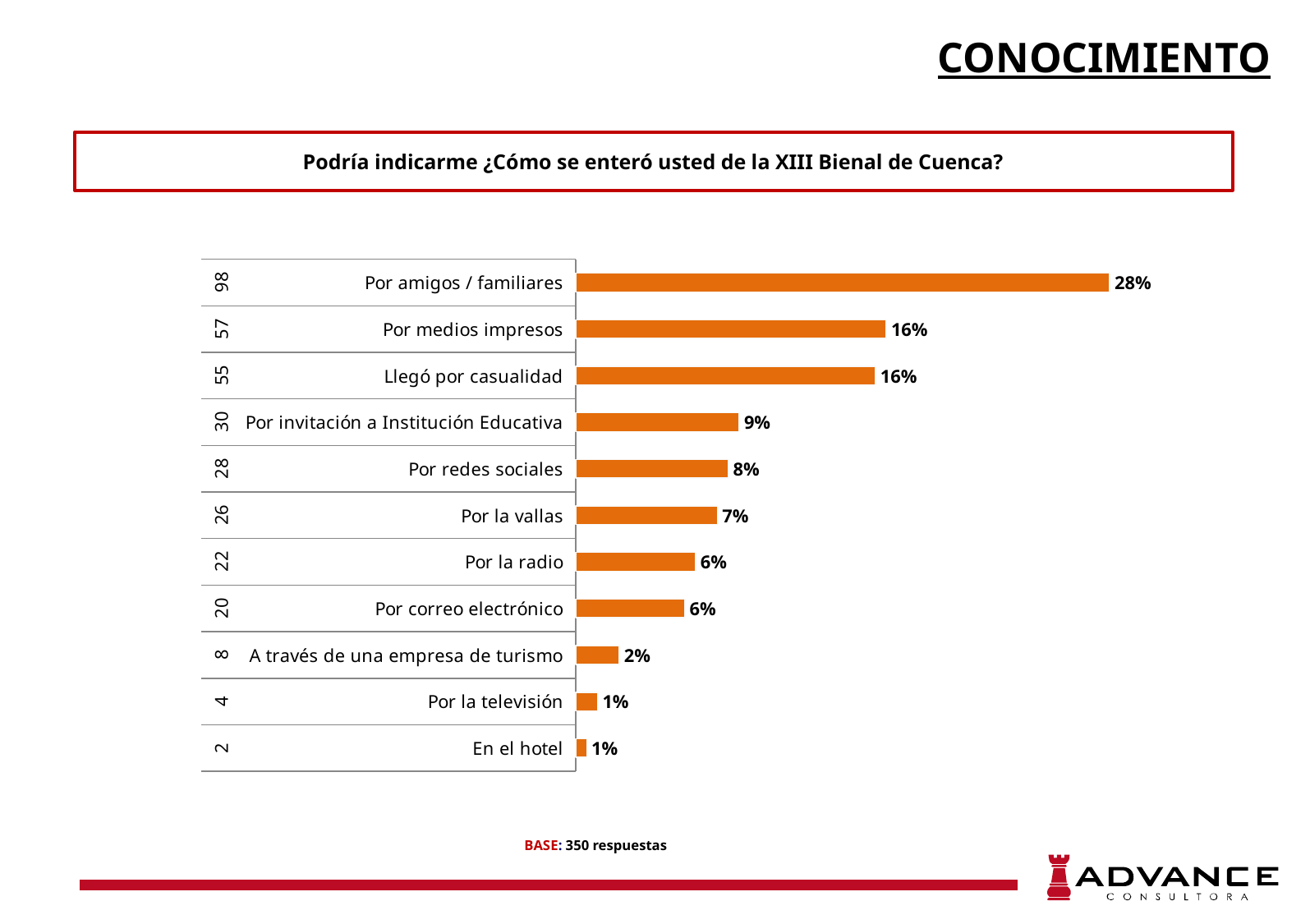
What type of chart is shown on the slide? Bar chart What percentage is shown for 'Por invitación a Institución Educativa'? 9% Which category has the highest percentage? Por amigos / familiares What percentage is shown for 'Por redes sociales'? 8% What is the difference between the respondent counts for 'Por medios impresos' and 'Llegó por casualidad'? 2 What percentage of respondents learned about the XIII Bienal de Cuenca through friends or family (Por amigos / familiares)? 28% What is the difference in percentage points between 'Por amigos / familiares' and 'Por la vallas'? 21 What is the base number of responses stated on the slide? 350 respuestas Which has a larger percentage, 'Por la radio' or 'A través de una empresa de turismo'? Por la radio How many respondents are listed next to 'Por medios impresos'? 57 Which category has the smallest count of respondents? En el hotel How many categories are shown in the chart? 11